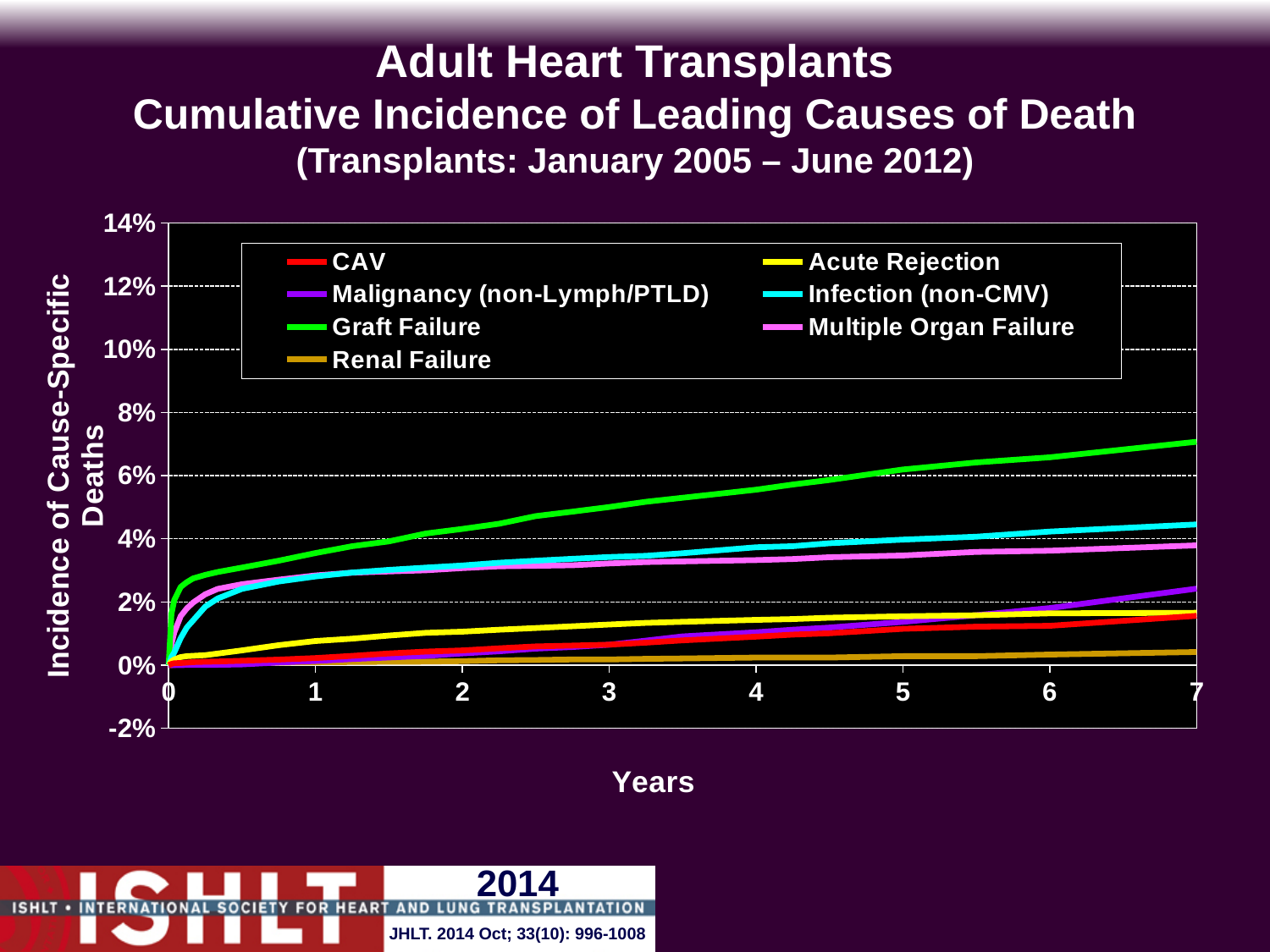
Which cause of death has the lowest cumulative incidence at 7 years? Renal Failure Does the Graft Failure line rise or fall as years increase? rise What kind of chart is shown on the slide? line chart Is the value for Graft Failure at 1 year greater or less than 2%? greater Is the value for Renal Failure at 7 years greater or less than 2%? less Is the value for Graft Failure at 7 years greater or less than 6%? greater What is the label of the x axis? Years How many series does the legend list? 7 At 7 years, which is larger: Graft Failure or Infection (non-CMV)? Graft Failure Which cause of death has the highest cumulative incidence at 7 years? Graft Failure At 7 years, which is larger: Malignancy (non-Lymph/PTLD) or Renal Failure? Malignancy (non-Lymph/PTLD)